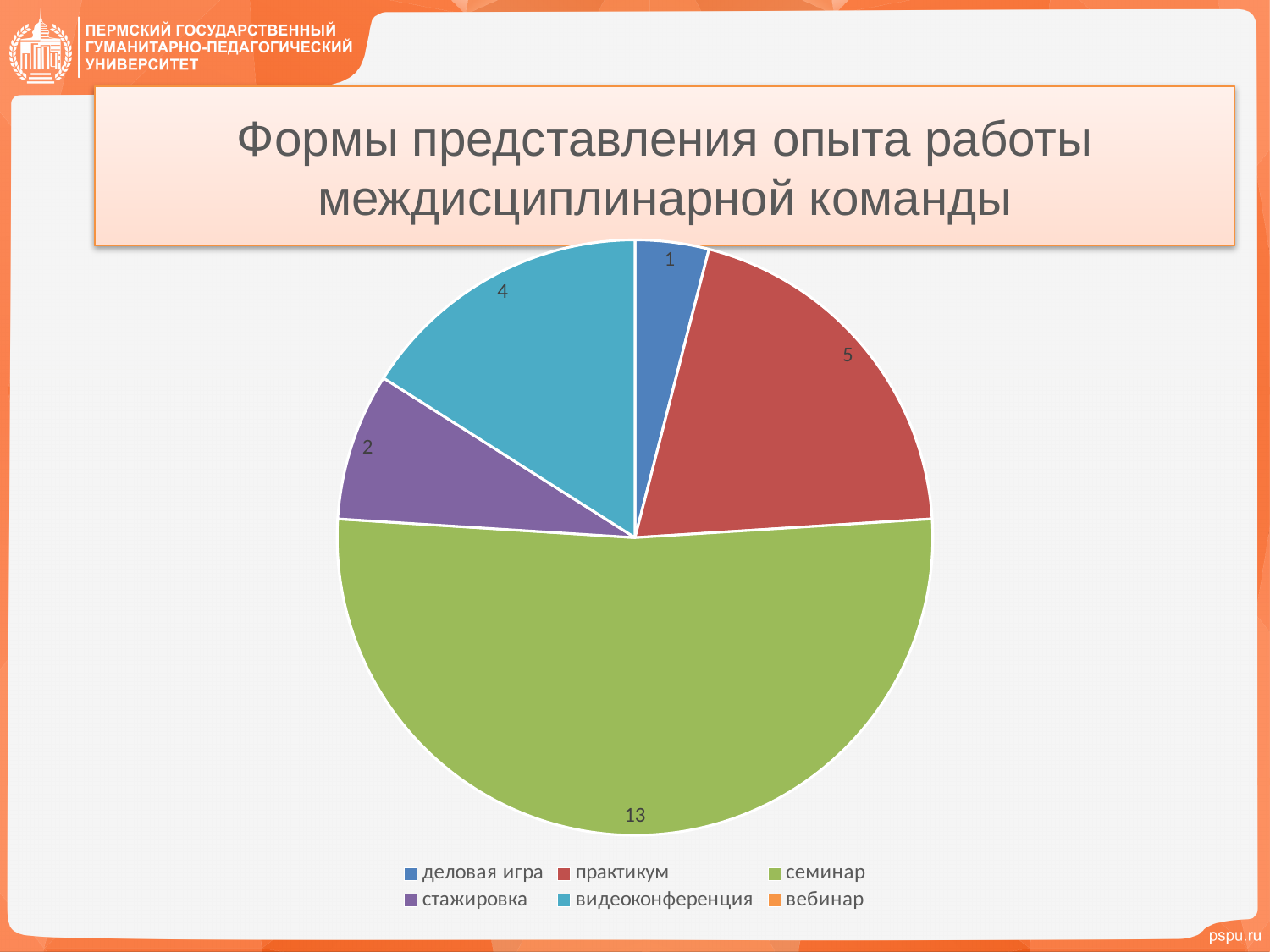
What value is shown for видеоконференция? 4 Which is larger, the value for видеоконференция or the value for стажировка? видеоконференция Which labelled slice has the smallest value? деловая игра What is the difference between the values for семинар and практикум? 8 What value is shown for стажировка? 2 What colour is the slice for семинар? green How many entries does the legend list? 6 What value is shown for семинар? 13 Which category has the largest slice of the pie? семинар What kind of chart is shown on the slide? pie chart What value is shown for практикум? 5 What value is shown for деловая игра? 1